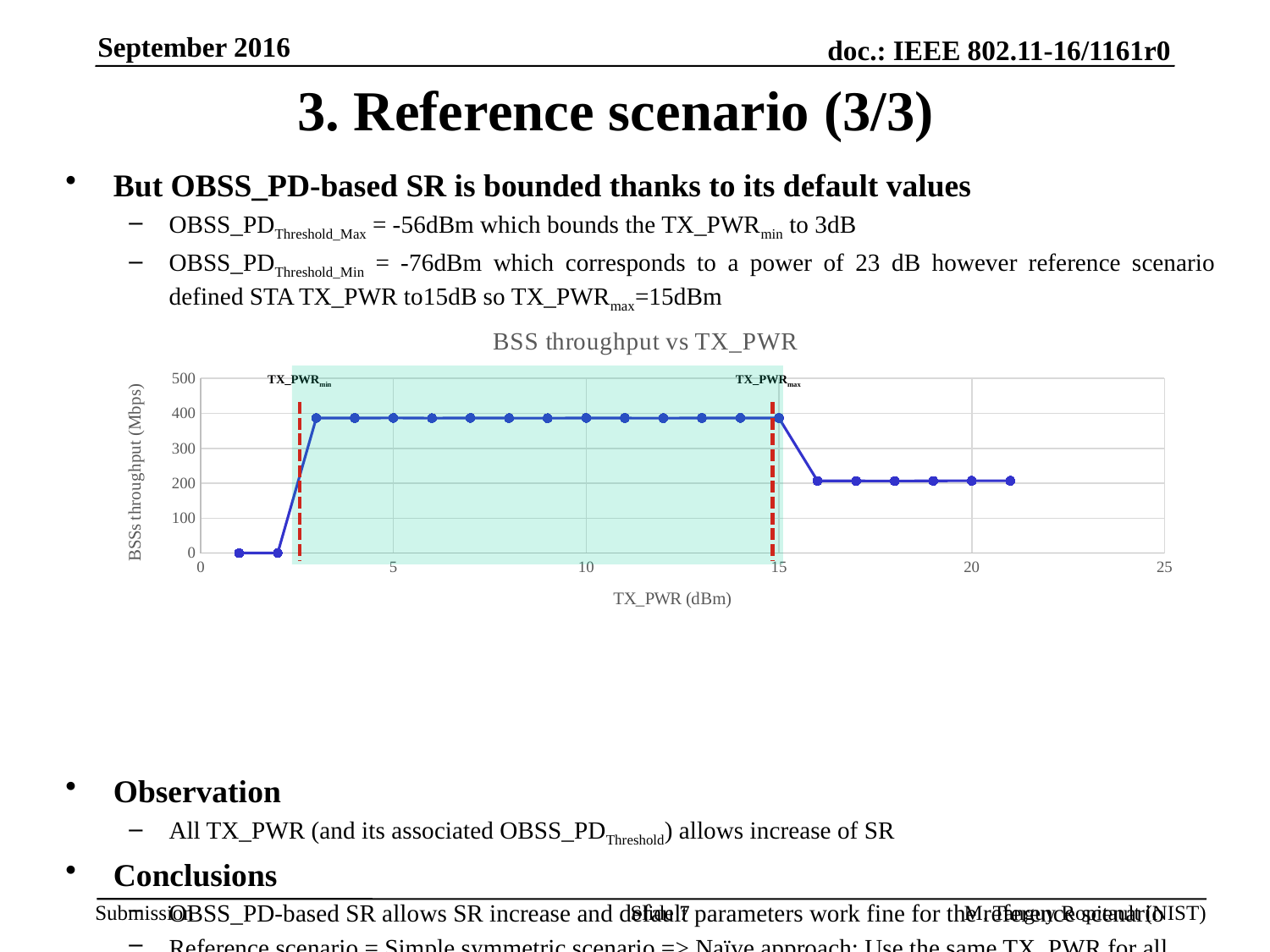
Does the BSS throughput rise or fall between TX_PWR = 15 dBm and TX_PWR = 16 dBm? fall Is the BSS throughput at TX_PWR = 18 dBm greater or less than 100 Mbps? greater Does the BSS throughput rise or fall between TX_PWR = 2 dBm and TX_PWR = 3 dBm? rise Is the BSS throughput at TX_PWR = 20 dBm greater or less than 300 Mbps? less What type of chart is shown on the slide? line chart What is the label of the x axis of the chart? TX_PWR (dBm) Which has the higher BSS throughput: TX_PWR = 10 dBm or TX_PWR = 20 dBm? TX_PWR = 10 dBm What is the BSS throughput value at TX_PWR = 2 dBm? 0 Is the BSS throughput at TX_PWR = 10 dBm greater or less than 300 Mbps? greater What is the BSS throughput value at TX_PWR = 1 dBm? 0 How many data points are plotted on the chart? 21 What is the title of the chart? BSS throughput vs TX_PWR